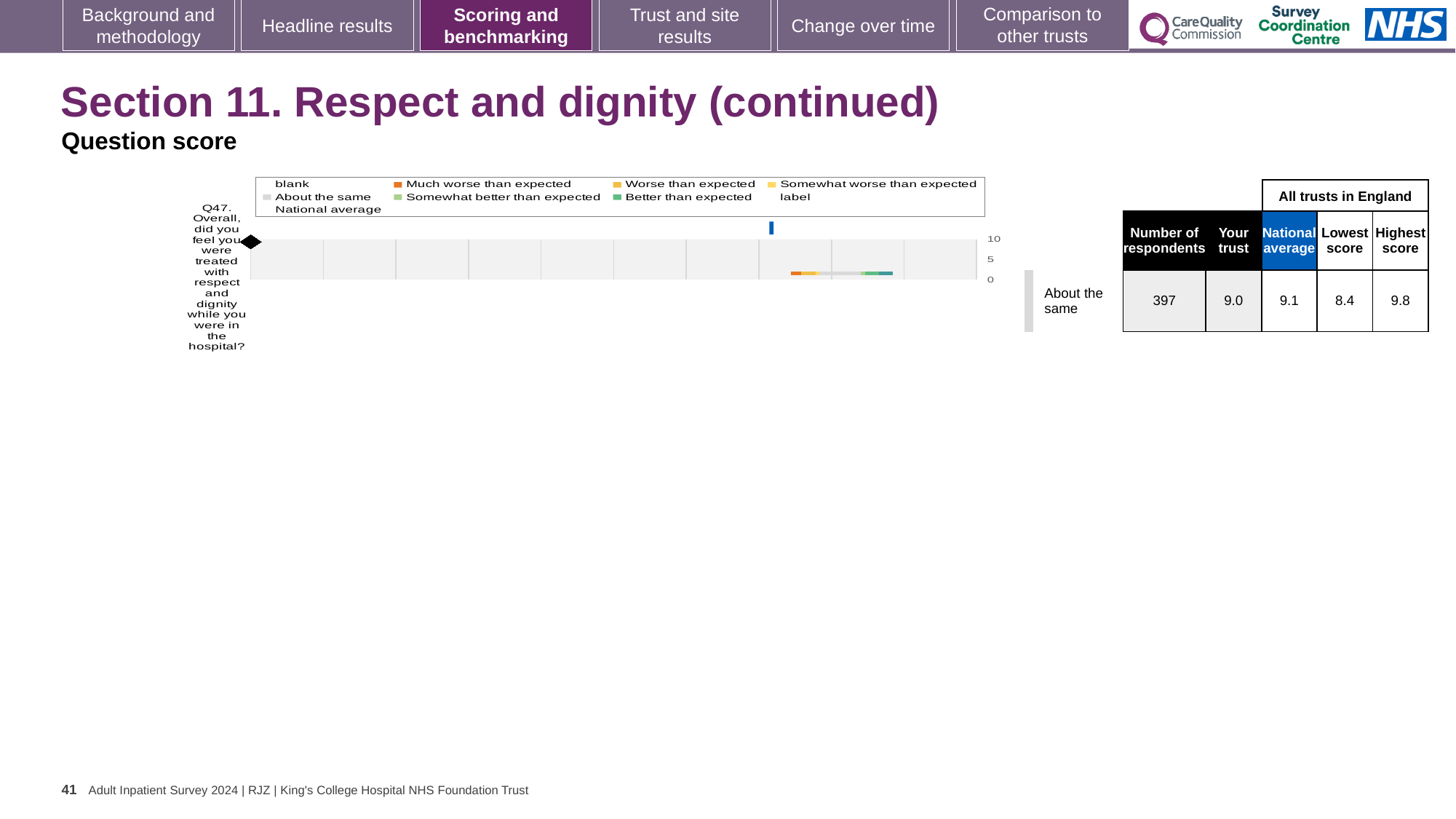
What is the 'Your trust' score for Q47? 9.0 What is the lowest score among all trusts in England for Q47? 8.4 How many questions are plotted in the chart? 1 What is the difference between the highest score and the lowest score for Q47? 1.4 What kind of chart is shown on the slide? bar chart How many entries does the chart legend list? 9 Which is larger for Q47, the 'Your trust' score or the national average? National average What is the maximum value shown on the chart's score axis? 10 What is the national average score for Q47? 9.1 Which benchmarking category is Q47 placed in? About the same How many respondents answered Q47? 397 What is the highest score among all trusts in England for Q47? 9.8